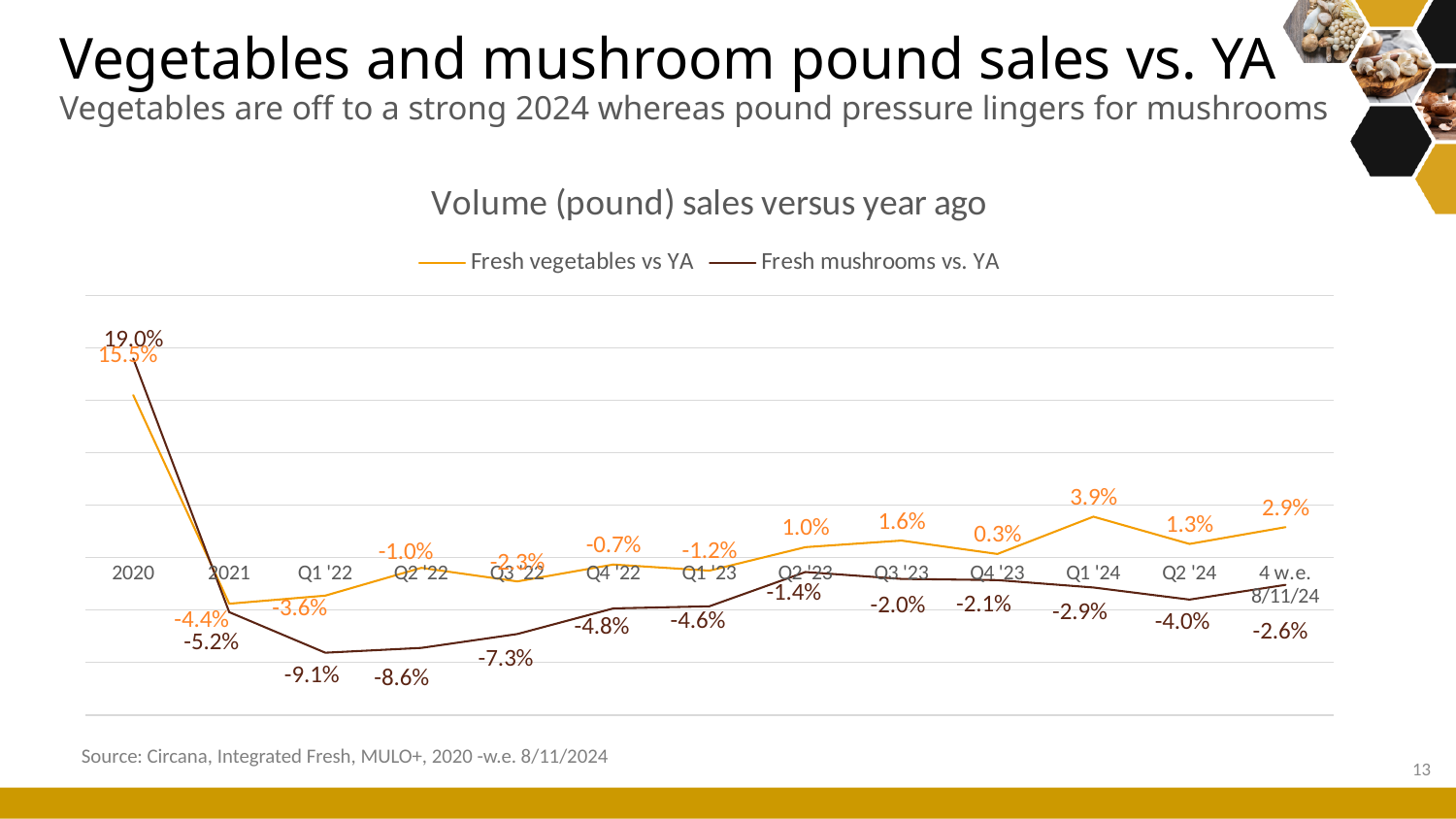
In which period is the Fresh mushrooms vs. YA value lowest? Q1 '22 What type of chart is shown on the slide? Line chart What is the value for Fresh vegetables vs YA in Q1 '24? 3.9% What is the value for Fresh mushrooms vs. YA for the 4 w.e. 8/11/24 period? -2.6% Does the Fresh mushrooms vs. YA line rise or fall from Q1 '22 to Q2 '23? Rise How many time periods are plotted along the x axis? 13 What is the difference between the Fresh mushrooms vs. YA value and the Fresh vegetables vs YA value in 2020? 3.5 percentage points In which period is the Fresh vegetables vs YA value highest? 2020 Which series has the higher value in Q2 '24, Fresh vegetables vs YA or Fresh mushrooms vs. YA? Fresh vegetables vs YA What is the title of the chart? Volume (pound) sales versus year ago How many series does the legend list? 2 What is the value for Fresh mushrooms vs. YA in Q1 '22? -9.1%